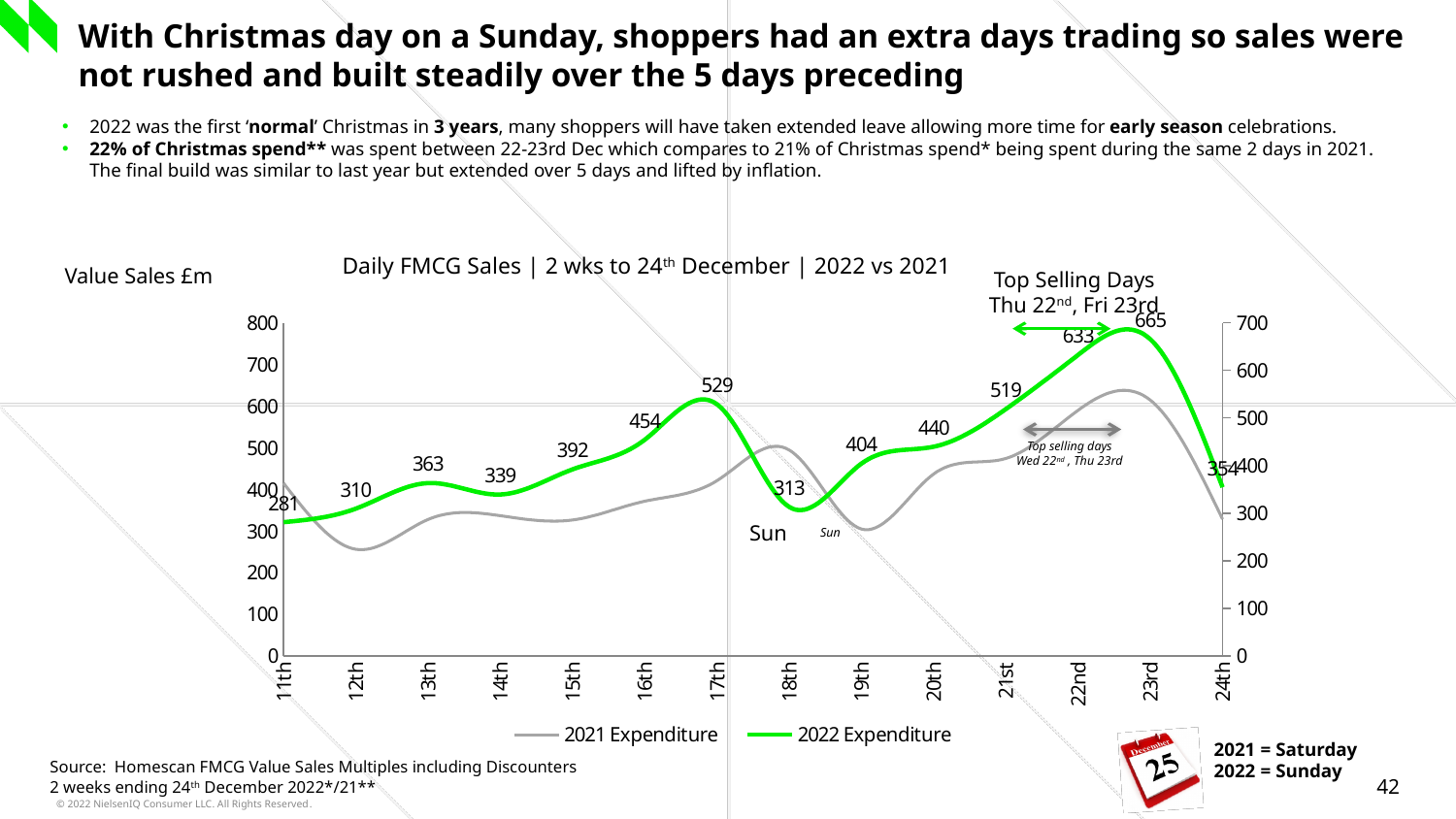
What is the difference between the 2022 Expenditure on the 23rd and on the 22nd? 32 What is the 2022 Expenditure value for the 18th? 313 How many series does the legend list? 2 What is the 2022 Expenditure value for the 23rd? 665 On which day is the 2022 Expenditure lowest? 11th What is the 2022 Expenditure value for the 17th? 529 What is the title of the chart? Daily FMCG Sales | 2 wks to 24th December | 2022 vs 2021 How many days are shown on the x axis? 14 What is the difference between the 2022 Expenditure on the 17th and on the 18th? 216 On which day is the 2022 Expenditure highest? 23rd Which day has the larger 2022 Expenditure, the 15th or the 16th? 16th What kind of chart is shown on the slide? line chart